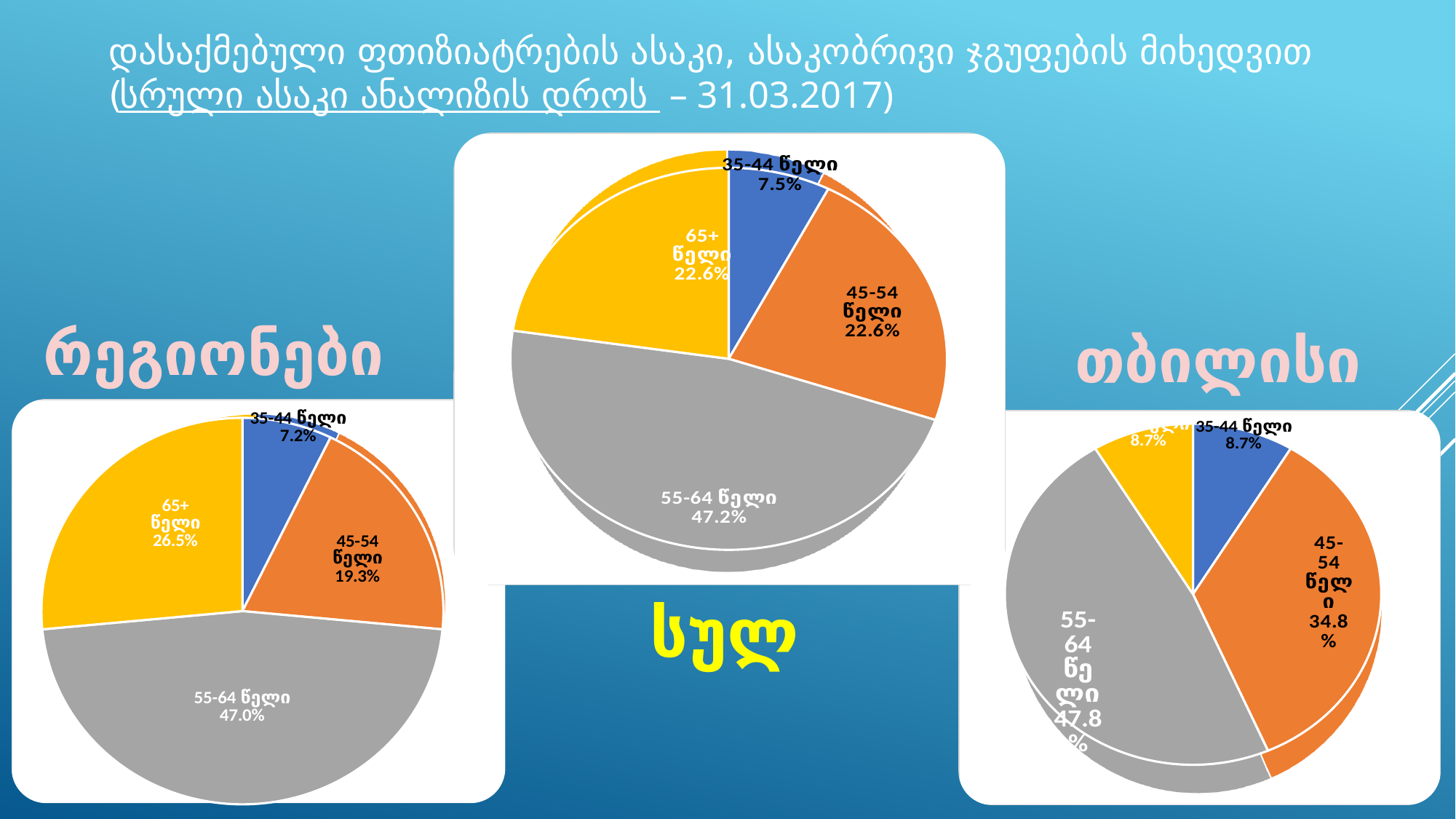
How many slices does the pie chart titled "სულ" (center) have? 4 In the pie chart titled "რეგიონები" (left), what is the share for 45-54 წელი? 19.3% In the pie chart titled "სულ" (center), what is the difference between the 55-64 წელი share and the 45-54 წელი share? 24.6% In the pie chart titled "სულ" (center), what colour is the 55-64 წელი slice? Grey In the pie chart titled "თბილისი" (right), which age group has the largest slice? 55-64 წელი In the pie chart titled "თბილისი" (right), what is the share for 45-54 წელი? 34.8% In the pie chart titled "რეგიონები" (left), what is the share for 65+ წელი? 26.5% In the pie chart titled "რეგიონები" (left), which age group has the smallest slice? 35-44 წელი What type of chart is used for "რეგიონები" (left)? Pie chart Which is larger: the 45-54 წელი share in the "თბილისი" chart or the 45-54 წელი share in the "რეგიონები" chart? თბილისი In the pie chart titled "სულ" (center), what is the share for 55-64 წელი? 47.2% How many pie charts are shown on the slide? 3